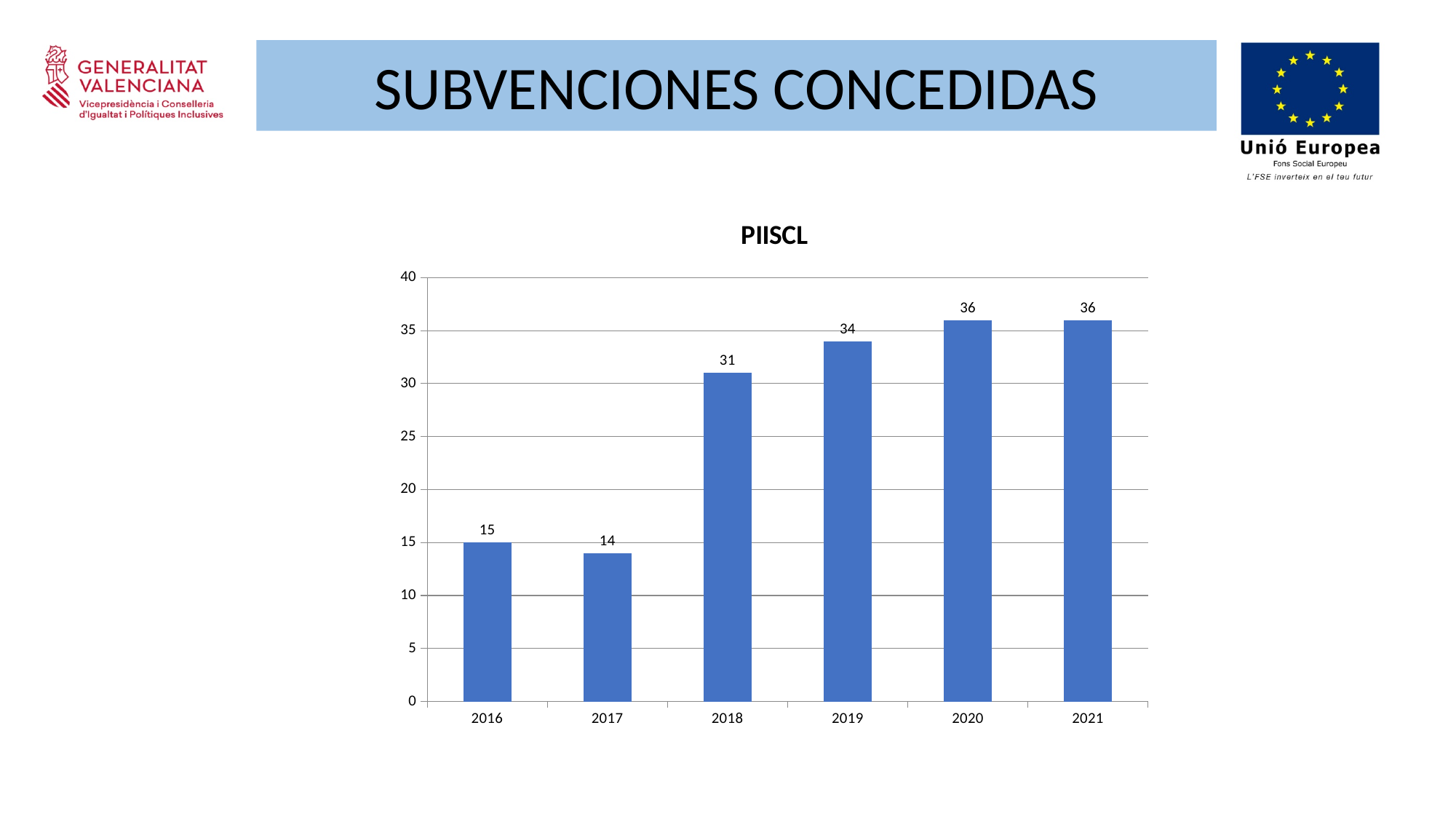
What is the difference between the values for 2020 and 2016? 21 What is the difference between the values for 2018 and 2017? 17 What is the value for 2019? 34 Which is larger, the value for 2019 or the value for 2018? 2019 What is the value for 2016? 15 What is the value for 2018? 31 Which year has the lowest value? 2017 Do the values generally rise or fall from 2017 to 2020? rise Is the value for 2021 greater or less than 30? greater What kind of chart is shown? bar chart How many years are shown on the x axis? 6 What is the title of the chart? PIISCL